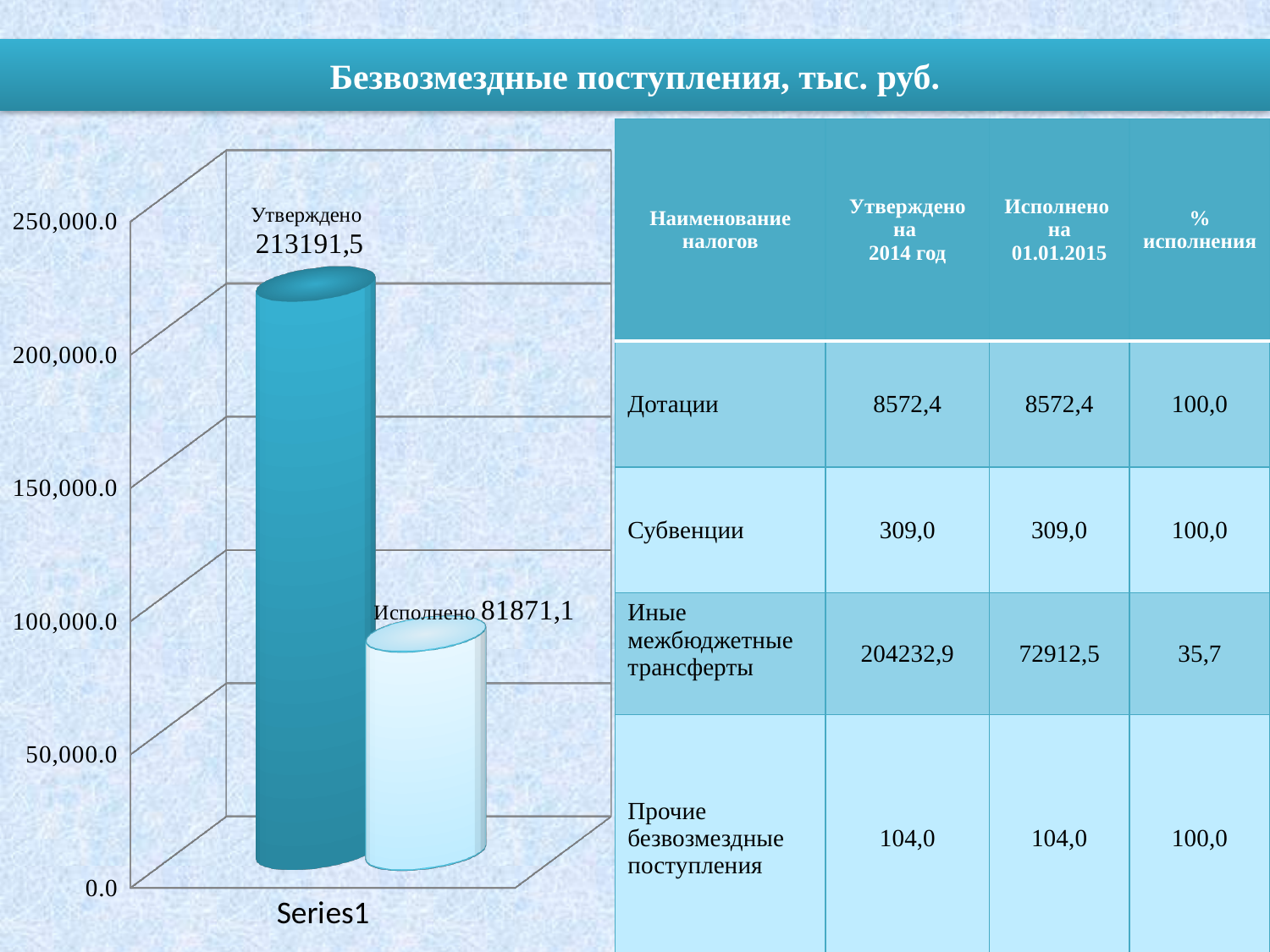
What label appears under the bars on the chart's horizontal axis? Series1 What is the difference between the Утверждено and Исполнено values in the chart? 131320,4 Which bar in the chart is the shortest? Исполнено What is the value of the Исполнено bar in the chart? 81871,1 What is the highest value shown on the chart's vertical axis? 250,000.0 What kind of chart is shown on the slide? bar chart Which bar in the chart is the tallest? Утверждено How many bars are plotted in the chart? 2 Is the value for Утверждено greater or less than 200,000.0? greater Is the value for Исполнено greater or less than 100,000.0? less What is the value of the Утверждено bar in the chart? 213191,5 Which is larger in the chart, Утверждено or Исполнено? Утверждено